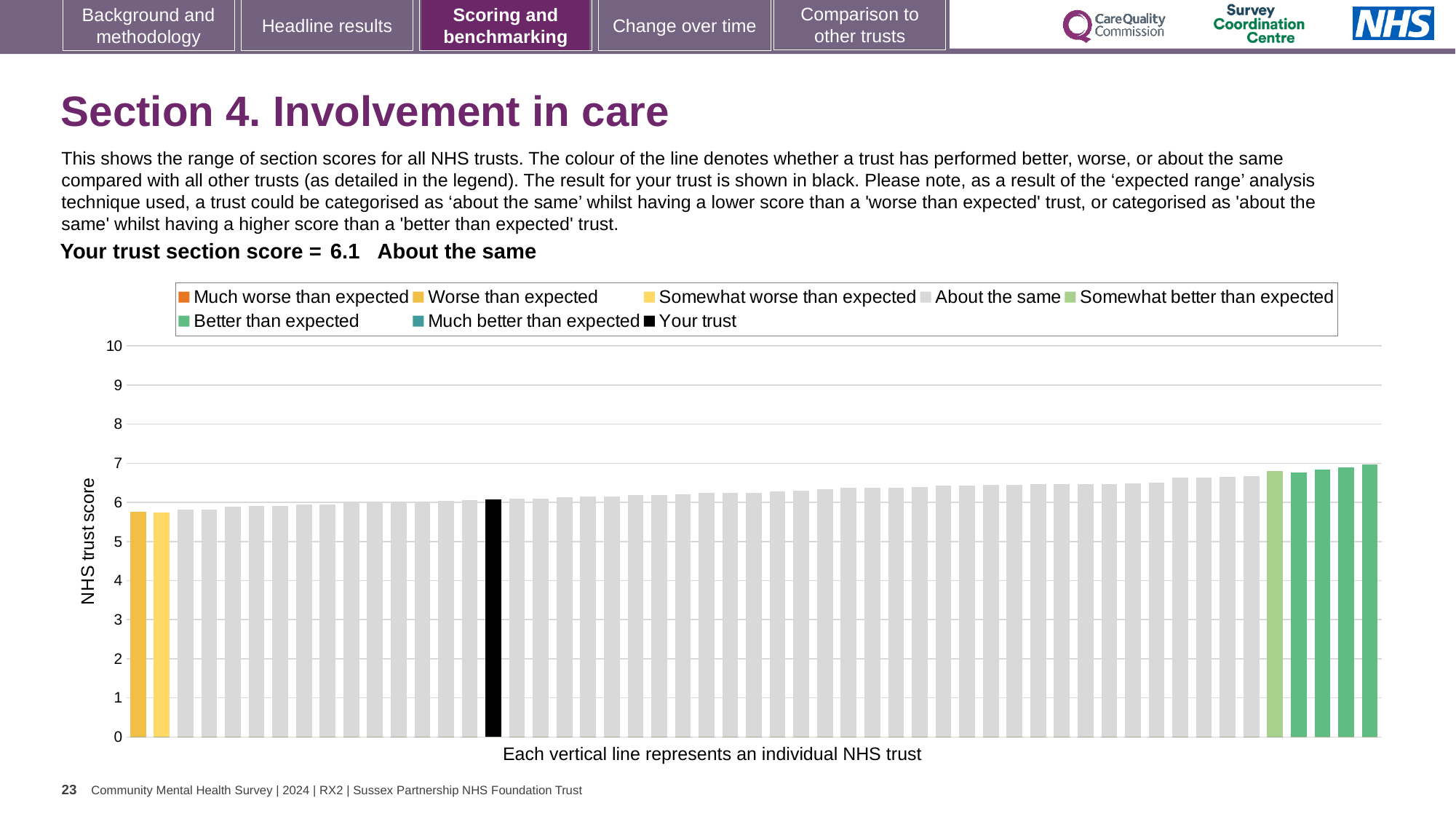
Which is higher: the black 'Your trust' bar or the leftmost bar in the chart? the black 'Your trust' bar What colour is used for the 'Your trust' bar in the chart? black Is the value for the lowest bar in the chart greater or less than 6? less How many entries does the chart legend list? 8 What is the label on the vertical axis of the chart? NHS trust score Do the bar values rise or fall moving from left to right along the x axis? rise What kind of chart is shown on the slide? bar chart Which legend category does the highest-scoring trust belong to? Better than expected Is the value for the highest bar in the chart greater or less than 6? greater Which category is the trust's section score placed in, according to the slide? About the same What is the trust's section score for Involvement in care? 6.1 Is the value for the trust's own (black) bar greater or less than 5? greater